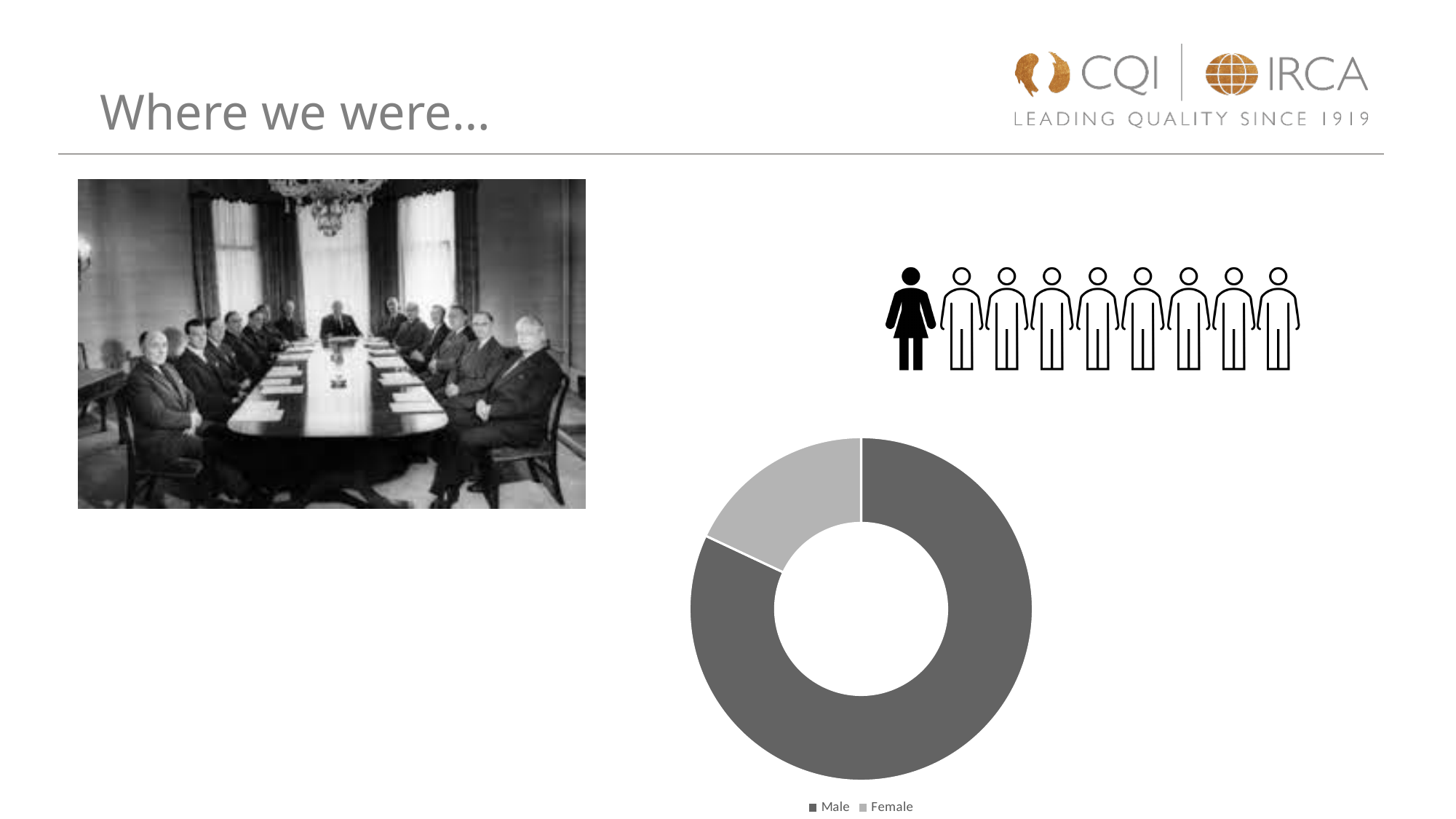
What kind of chart is shown on the slide? Doughnut chart Which category is shown in the lighter grey colour in the doughnut chart? Female Which category has the largest share of the doughnut chart? Male How many categories does the doughnut chart show? 2 What are the two categories listed in the legend of the doughnut chart? Male and Female Which category has the smallest share of the doughnut chart? Female How many entries does the legend of the doughnut chart list? 2 Which is larger in the doughnut chart, Male or Female? Male